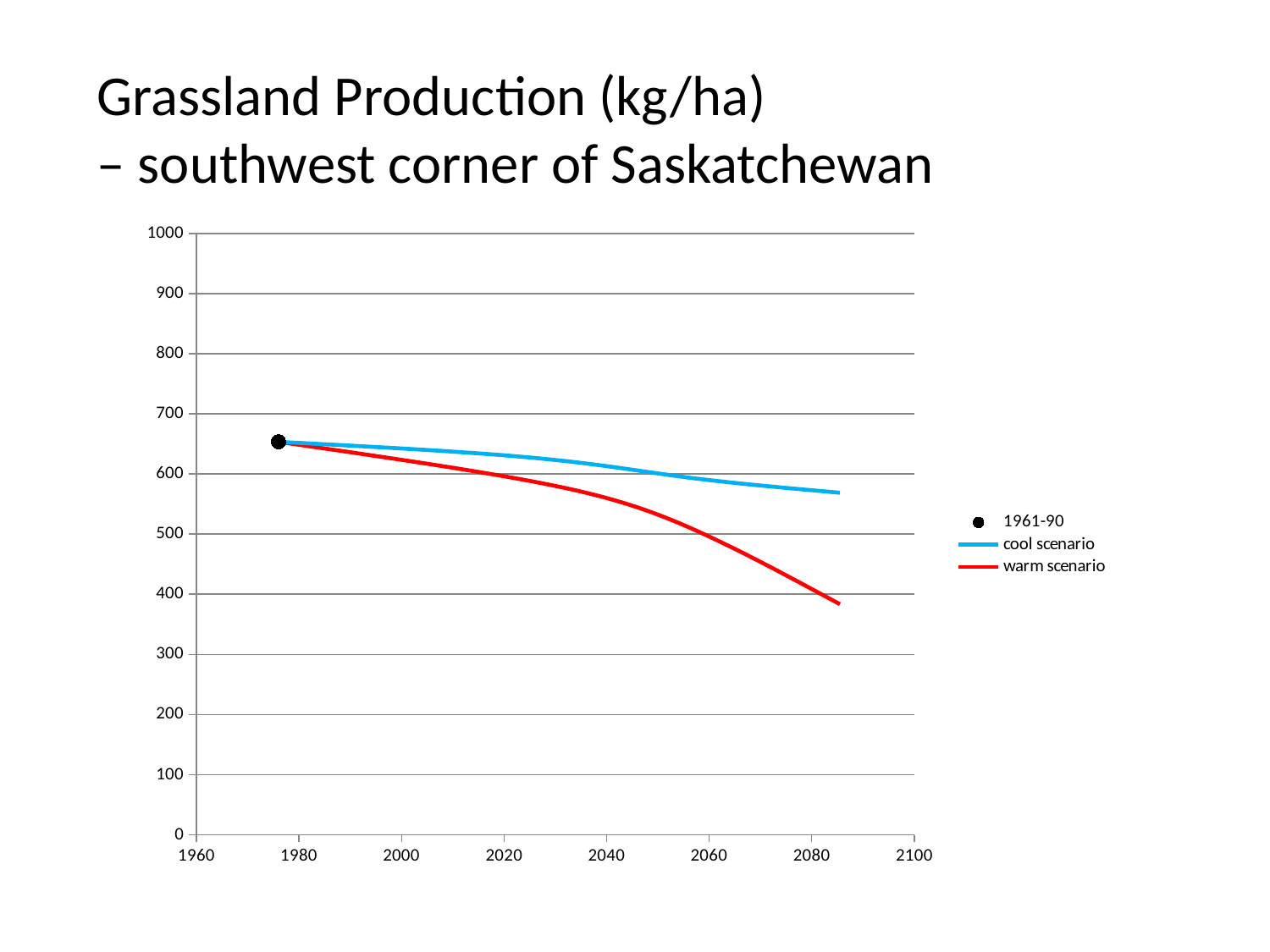
Which scenario line ends at the lowest value on the chart? warm scenario Does the cool scenario line rise or fall from 1980 to 2080? fall Is the 1961-90 value (the black dot) greater or less than 600? greater How many entries does the legend list? 3 Around 2080, which scenario shows higher grassland production, cool or warm? cool scenario Is the value of the warm scenario at its end point (around 2085) greater or less than 500? less What is the title of the chart? Grassland Production (kg/ha) – southwest corner of Saskatchewan What kind of chart is shown on the slide? line chart Is the value of the cool scenario at its end point (around 2085) greater or less than 600? less Which colour is used for the warm scenario line? red Does the warm scenario line rise or fall from 1980 to 2080? fall